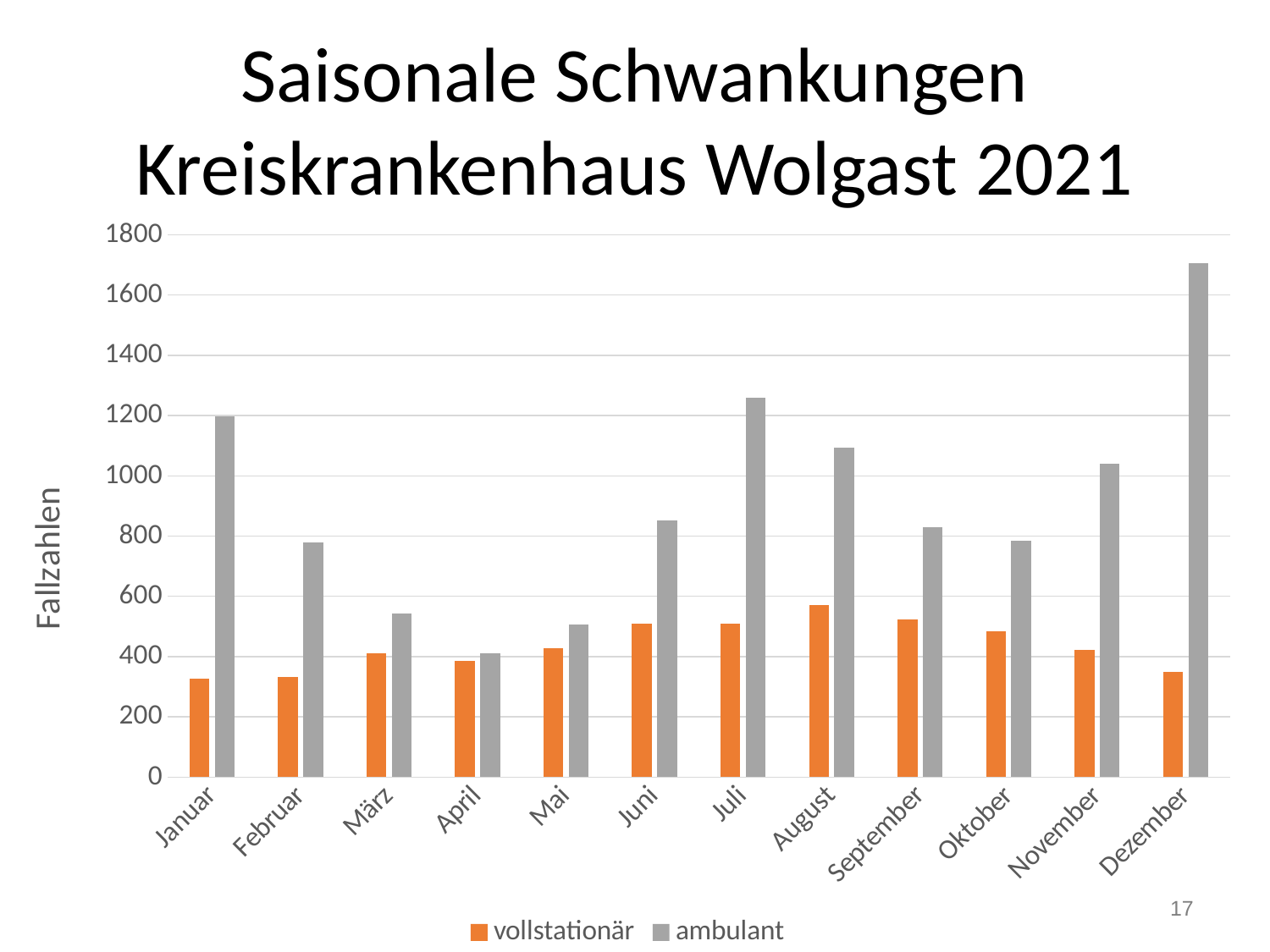
How many months are shown on the x axis? 12 Which is larger, the vollstationär value for August or the vollstationär value for Januar? August Is the ambulant value for Dezember greater or less than 1600? greater Is the ambulant value for April greater or less than 600? less What kind of chart is shown on the slide? bar chart Is the vollstationär value for Dezember greater or less than 400? less In which month is the ambulant value lowest? April In which month is the vollstationär value highest? August Which is larger, the ambulant value for Juli or the ambulant value for August? Juli In which month is the ambulant value highest? Dezember What is the label on the vertical axis? Fallzahlen How many series does the legend list? 2